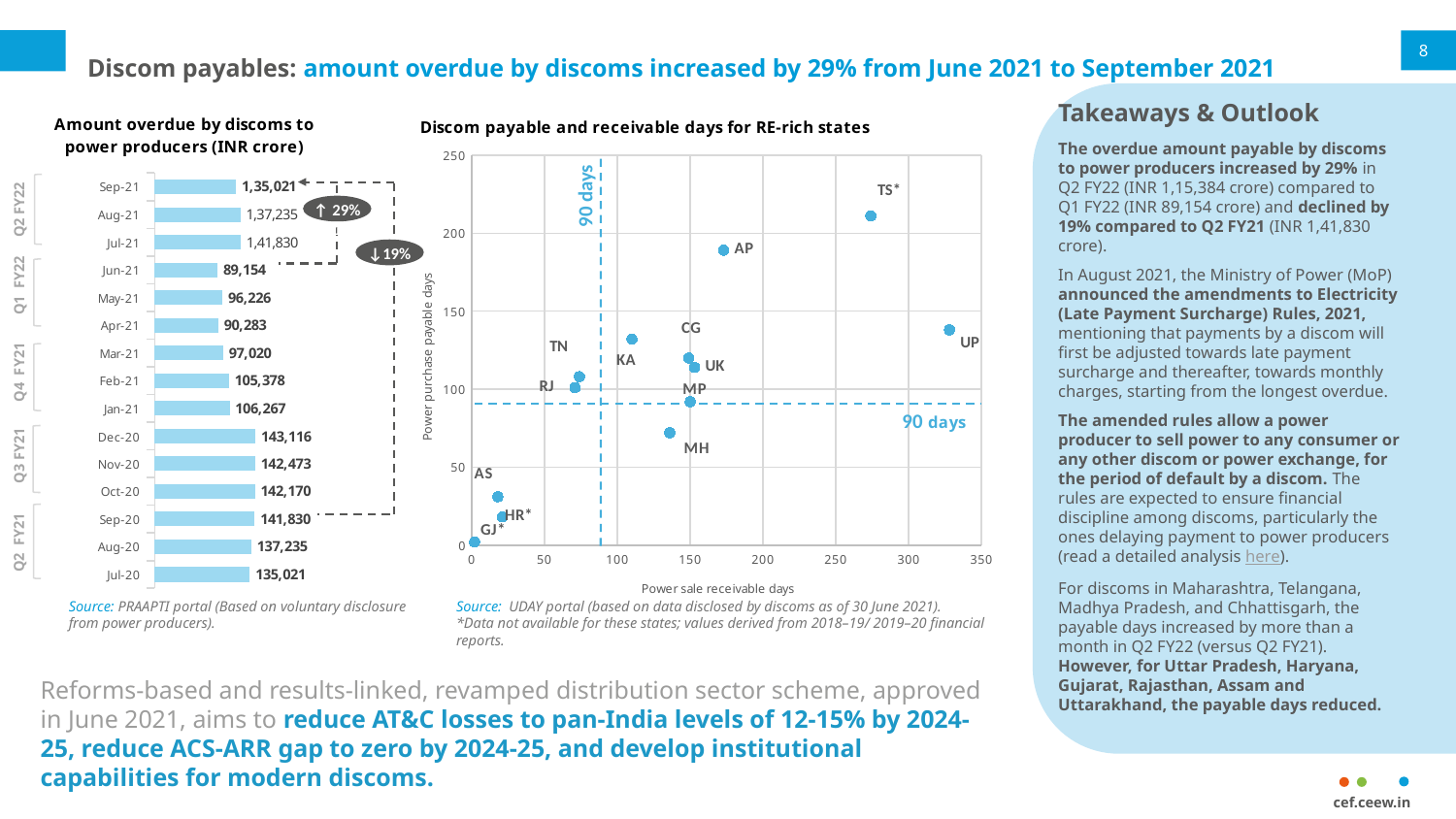
In the chart 'Amount overdue by discoms to power producers (INR crore)', which is larger, the value for Feb-21 or the value for Mar-21? Feb-21 In the chart 'Amount overdue by discoms to power producers (INR crore)', which month has the lowest value? Jun-21 In the chart 'Amount overdue by discoms to power producers (INR crore)', what is the value for Sep-21? 1,35,021 What kind of chart is 'Discom payable and receivable days for RE-rich states'? Scatter chart In the chart 'Discom payable and receivable days for RE-rich states', is the power sale receivable days value for UP greater or less than 300? greater What kind of chart is 'Amount overdue by discoms to power producers (INR crore)'? Bar chart In the chart 'Amount overdue by discoms to power producers (INR crore)', which month has the highest value? Dec-20 In the chart 'Discom payable and receivable days for RE-rich states', is the power purchase payable days value for TS* greater or less than 200? greater In the chart 'Amount overdue by discoms to power producers (INR crore)', what is the value for Dec-20? 143,116 In the chart 'Amount overdue by discoms to power producers (INR crore)', what is the difference between the values for Jul-21 and Jun-21? 52,676 How many months are shown in the chart 'Amount overdue by discoms to power producers (INR crore)'? 15 In the chart 'Amount overdue by discoms to power producers (INR crore)', what is the value for Jun-21? 89,154